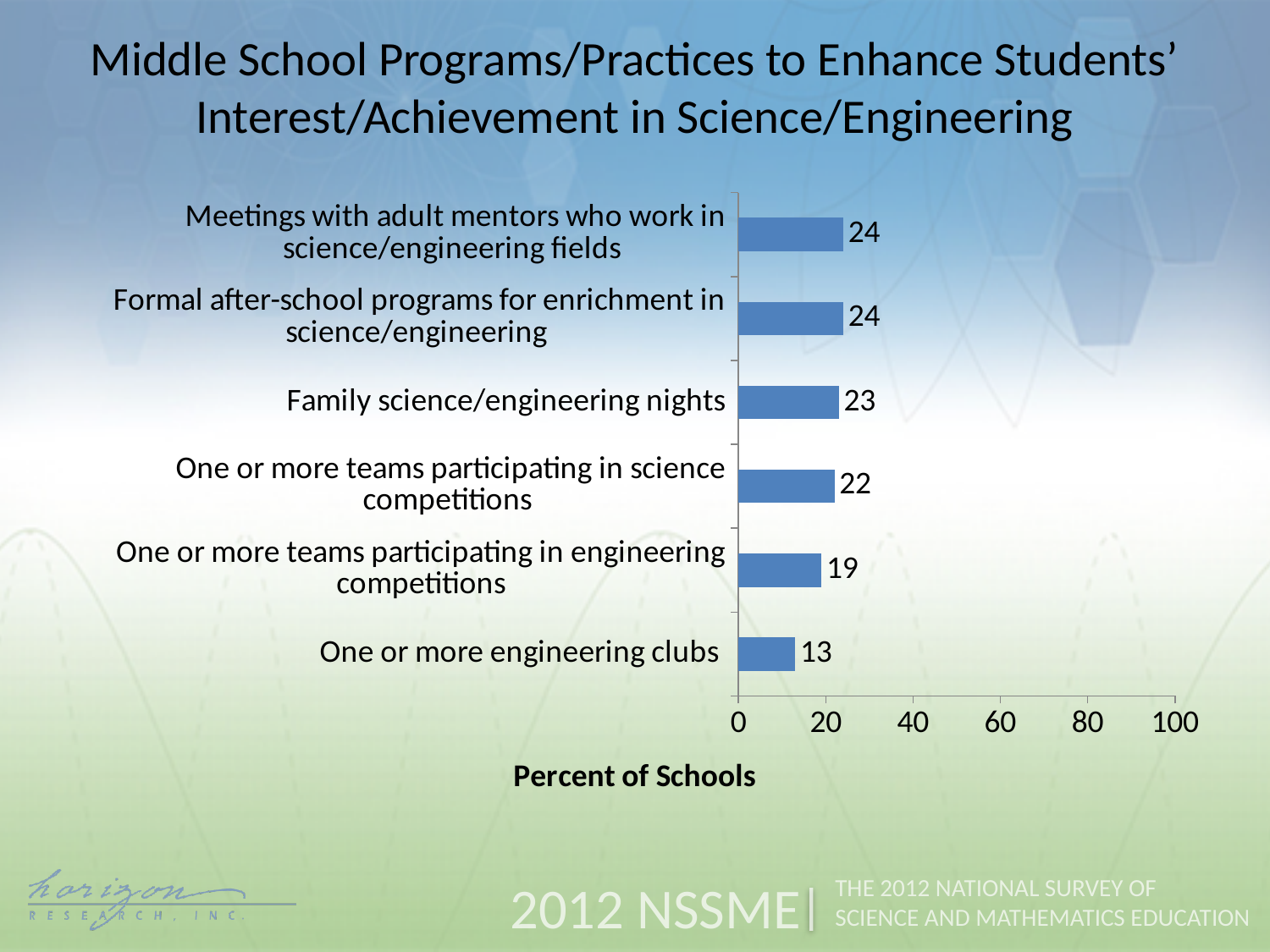
What is the difference between the value for one or more teams participating in science competitions and the value for one or more engineering clubs? 9 What is the value for family science/engineering nights? 23 What is the maximum value shown on the horizontal axis? 100 What kind of chart is shown on the slide? Bar chart What is the label of the horizontal axis? Percent of Schools Which program/practice has the lowest percent of schools? One or more engineering clubs What percent of schools have one or more teams participating in engineering competitions? 19 What percent of schools report one or more engineering clubs? 13 What is the value for formal after-school programs for enrichment in science/engineering? 24 Is the value for meetings with adult mentors who work in science/engineering fields greater or less than 20? greater How many programs/practices are shown in the chart? 6 Which is larger: the value for family science/engineering nights or the value for one or more teams participating in engineering competitions? Family science/engineering nights